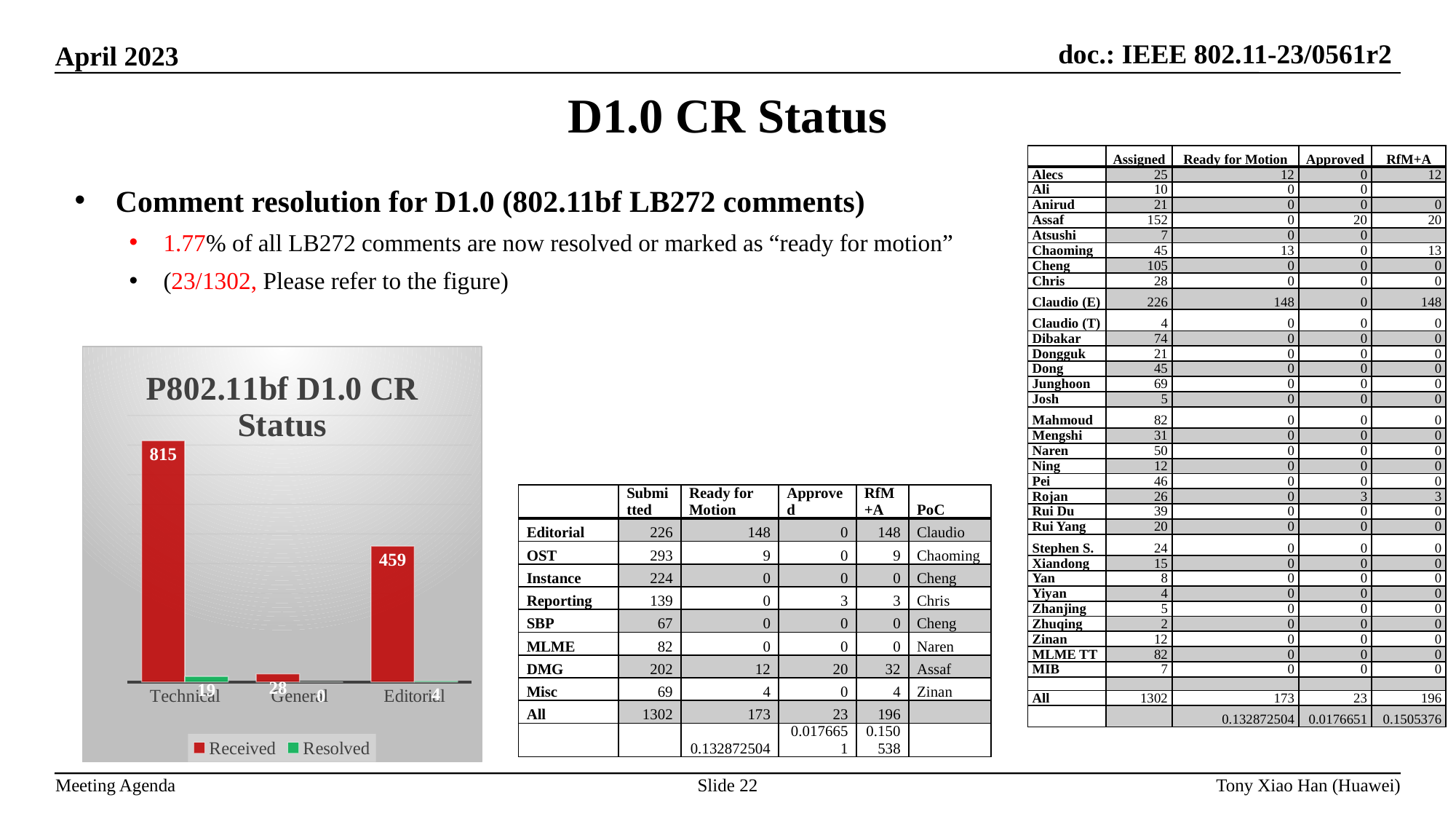
What type of chart is shown on the slide? bar chart How many series does the chart legend list? 2 What is the Received value for Technical in the chart? 815 What is the difference between the Received values for Technical and Editorial? 356 How many categories are shown on the x axis of the chart? 3 Which is larger in the chart, the Received value for Editorial or the Received value for General? Editorial What is the title of the chart on the slide? P802.11bf D1.0 CR Status What is the Received value for General in the chart? 28 What is the Received value for Editorial in the chart? 459 What are the two series named in the chart legend? Received and Resolved Which category has the highest Received value in the chart? Technical Which category has the lowest Received value in the chart? General